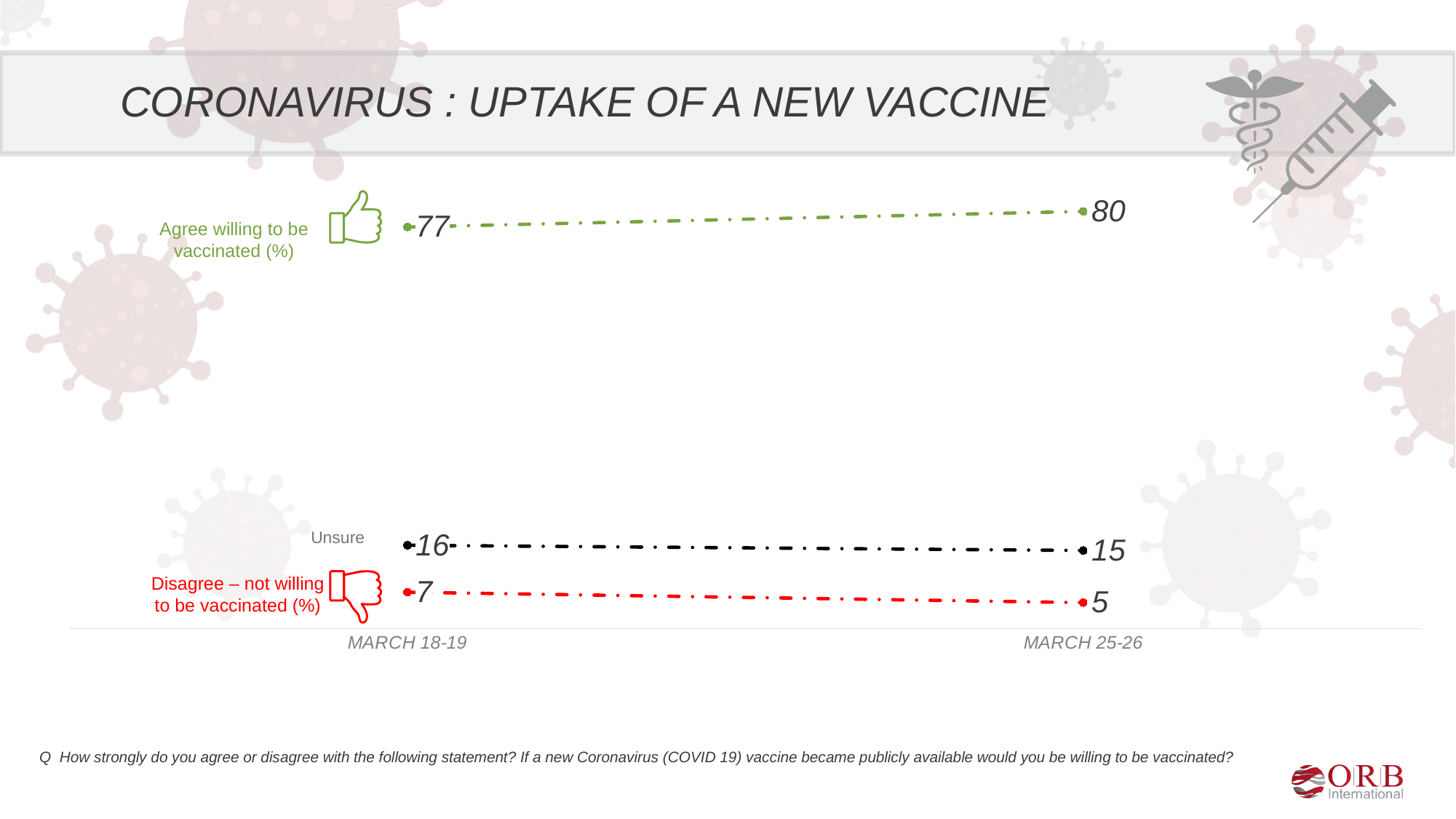
What percentage agreed they were willing to be vaccinated in the March 18-19 wave? 77 Did the Disagree – not willing to be vaccinated value rise or fall from March 18-19 to March 25-26? fall Did the Agree willing to be vaccinated value rise or fall from March 18-19 to March 25-26? rise Which series had the highest value in the March 25-26 wave? Agree willing to be vaccinated (%) What was the Unsure value for March 25-26? 15 Which series had the lowest value in the March 18-19 wave? Disagree – not willing to be vaccinated (%) What percentage agreed they were willing to be vaccinated in the March 25-26 wave? 80 How many survey waves are shown on the x axis? 2 By how many points did the Agree willing to be vaccinated value change between March 18-19 and March 25-26? 3 What is the difference between the Unsure value and the Disagree value for March 25-26? 10 What was the Disagree – not willing to be vaccinated value for March 18-19? 7 What type of chart is shown on the slide? line chart